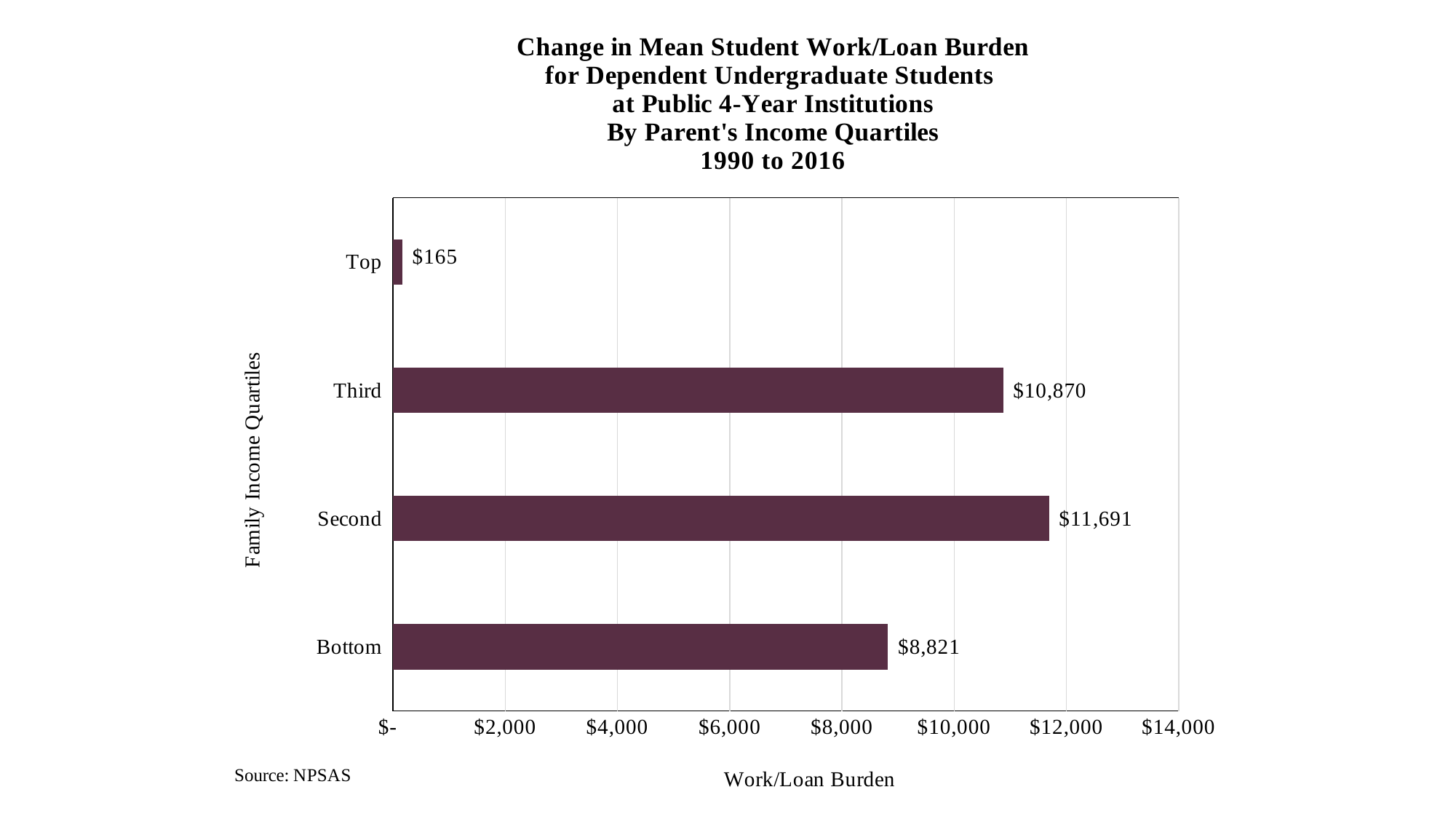
What is the change in mean work/loan burden for the Second income quartile? $11,691 What is the difference between the Second and Third quartile values? $821 What is the label of the horizontal axis? Work/Loan Burden Which income quartile has the lowest change in work/loan burden? Top What is the change in mean work/loan burden for the Top income quartile? $165 What is the difference between the Bottom and Top quartile values? $8,656 Which has a larger change in work/loan burden, the Bottom quartile or the Third quartile? Third What is the change in mean work/loan burden for the Bottom income quartile? $8,821 How many income quartiles are shown in the chart? 4 What type of chart is shown on the slide? Bar chart What is the change in mean work/loan burden for the Third income quartile? $10,870 Which income quartile has the highest change in work/loan burden? Second